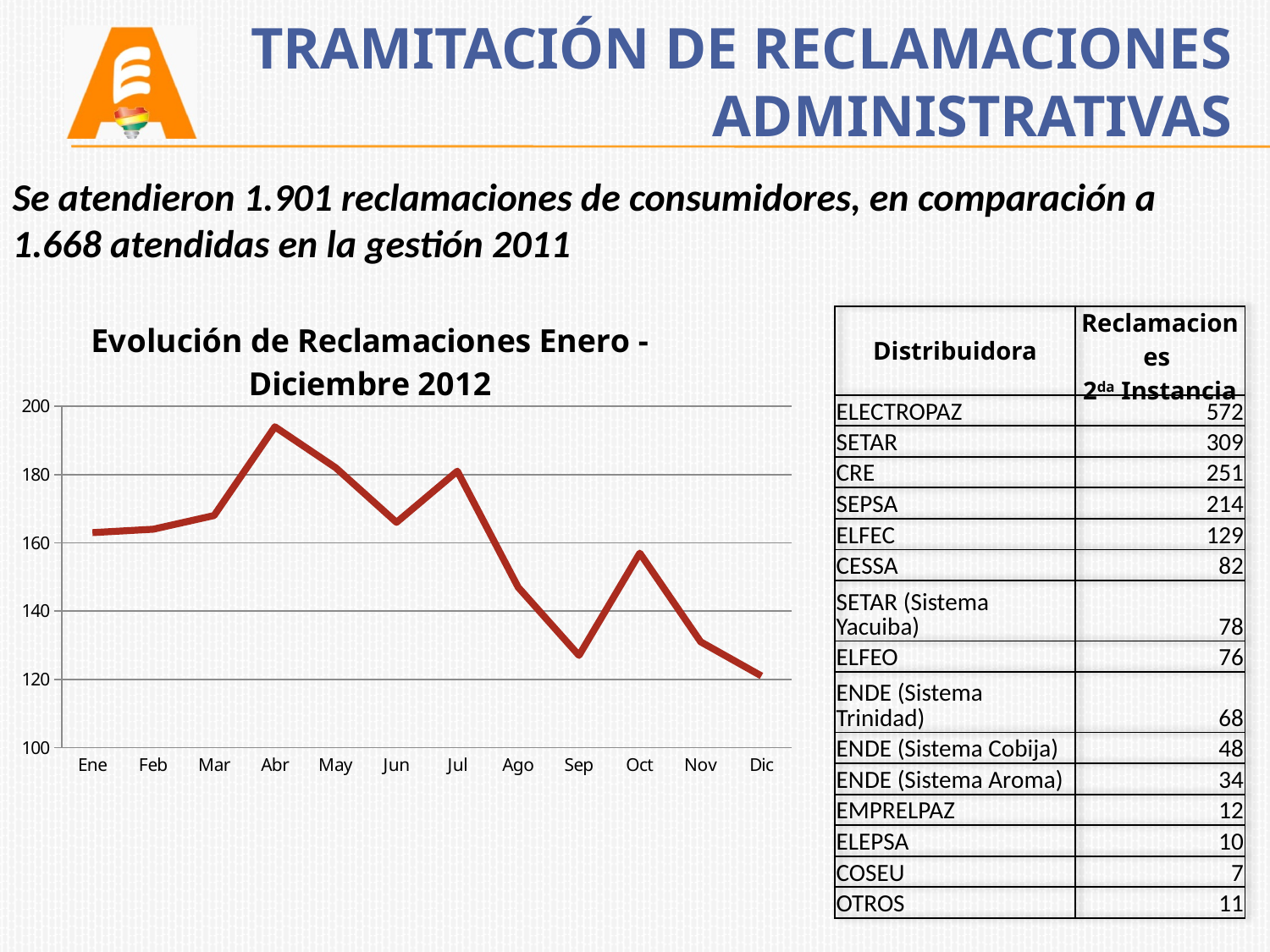
Is the value for Dic greater or less than 140? less How many months are plotted along the x axis of the chart? 12 Which month has the larger value, Abr or Sep? Abr What kind of chart is shown on the slide? line chart Which month has the larger value, Oct or Nov? Oct In which month does the line reach its highest value? Abr In which month does the line reach its lowest value? Dic Is the value for Sep greater or less than 140? less Overall, do the values rise or fall from Ene to Dic? fall Is the value for Ene greater or less than 160? greater What is the title of the chart on the slide? Evolución de Reclamaciones Enero - Diciembre 2012